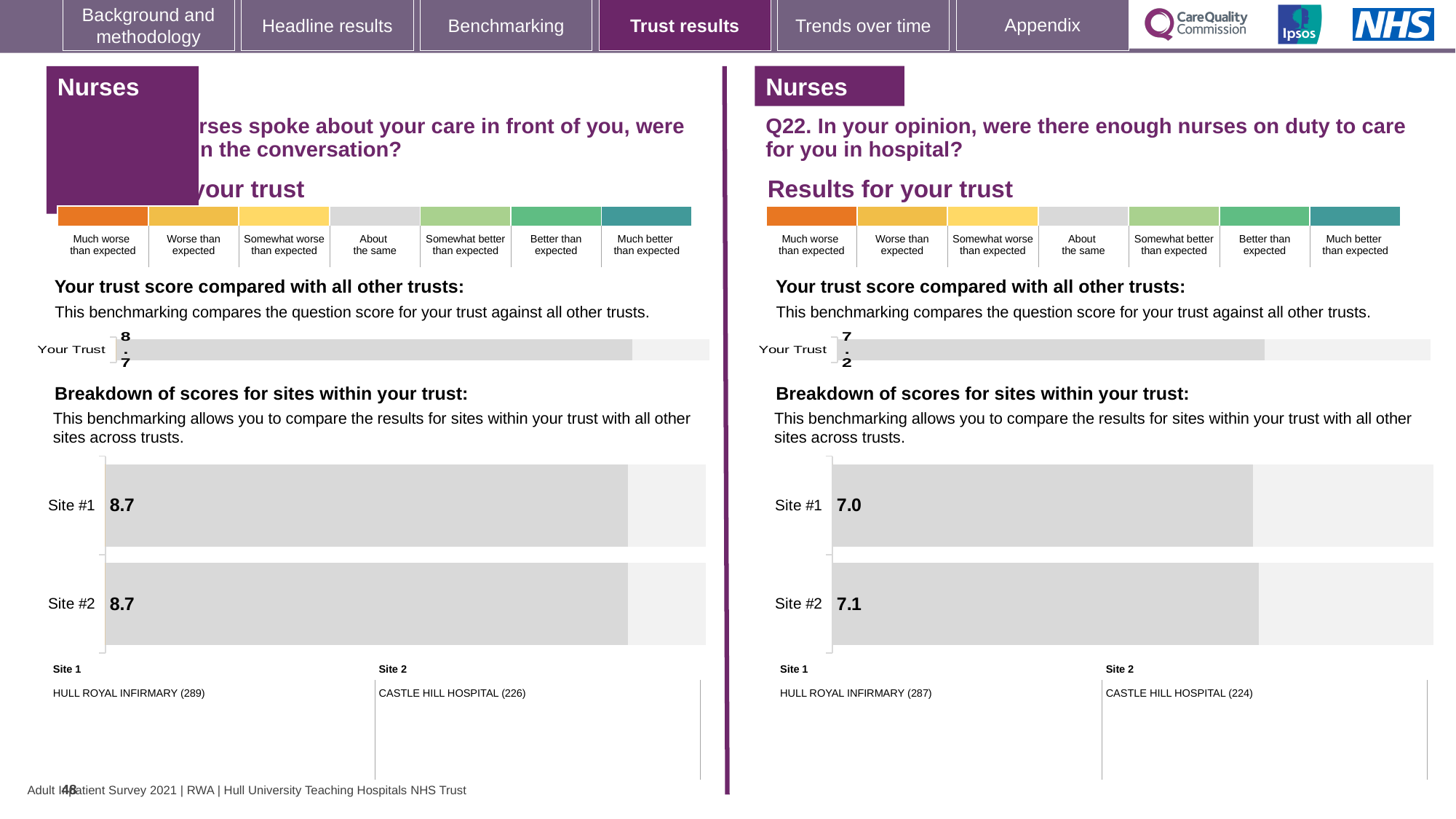
On the left-hand panel, what is the score shown for Site #1 in the breakdown of scores for sites within your trust? 8.7 What type of chart is used for the breakdown of scores for sites within your trust on the left-hand panel? Bar chart Is the Site #1 score on the left-hand panel larger than the Site #1 score on the right-hand panel (Q22)? Yes On the right-hand panel (Q22), what is the score shown for Site #2 in the breakdown of scores for sites within your trust? 7.1 How many sites are shown in the breakdown of scores chart on the right-hand panel (Q22)? 2 On the right-hand panel (Q22), what is the difference between the Site #2 score and the Site #1 score? 0.1 On the left-hand panel, what is the score shown for Site #2 in the breakdown of scores for sites within your trust? 8.7 On the left-hand panel, what is the 'Your Trust' score in the chart comparing the trust with all other trusts? 8.7 On the right-hand panel (Q22), which hospital is listed as Site 1 below the breakdown chart? HULL ROYAL INFIRMARY (287) On the right-hand panel (Q22), what is the 'Your Trust' score in the chart comparing the trust with all other trusts? 7.2 On the right-hand panel (Q22), which site has the higher score in the breakdown of scores for sites within your trust? Site #2 On the right-hand panel (Q22), what is the score shown for Site #1 in the breakdown of scores for sites within your trust? 7.0